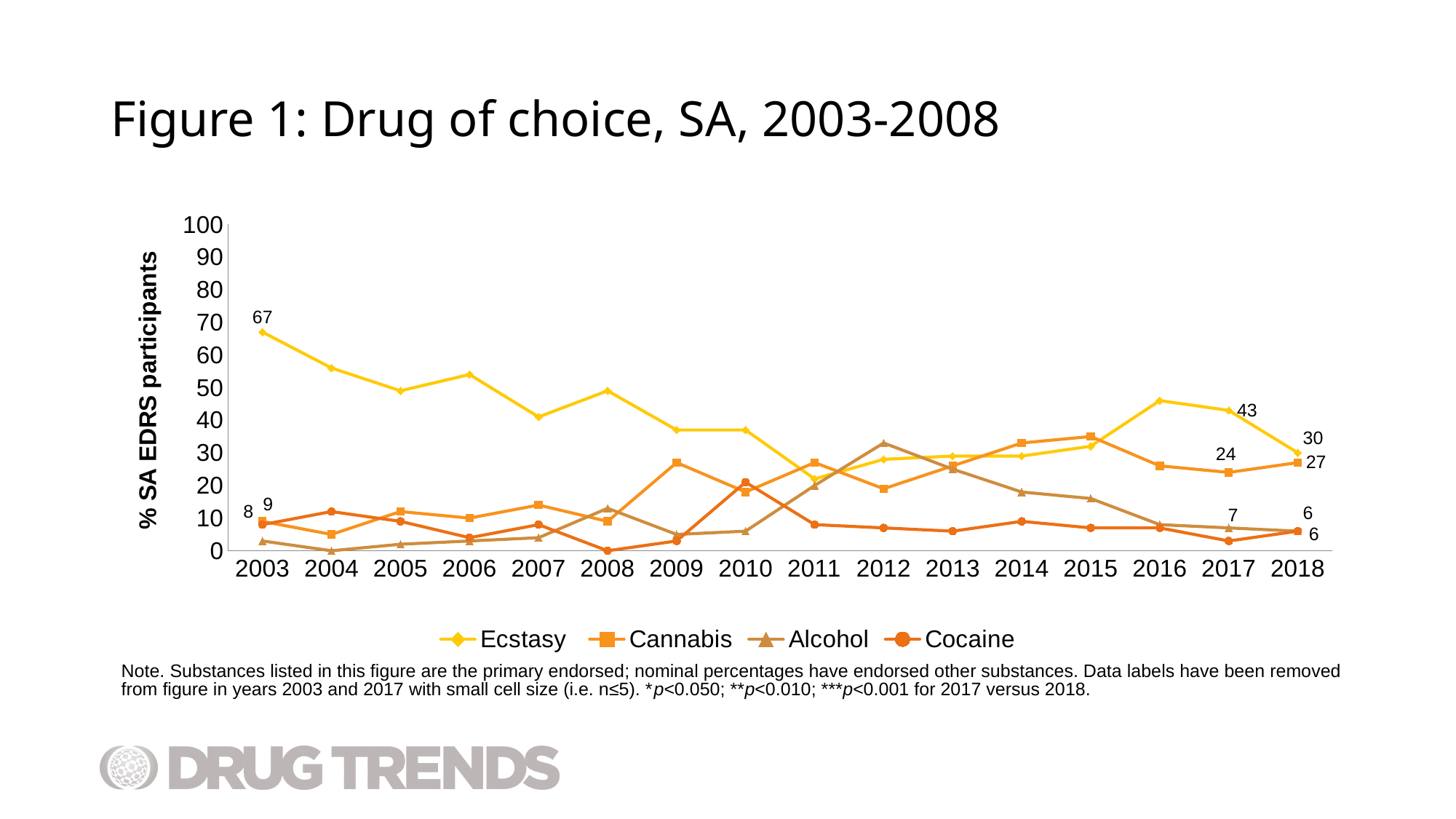
By how much did the Ecstasy value fall between 2003 and 2018? 37 How many years are shown along the x axis? 16 What is the value for Cannabis in 2018? 27 What is the value for Cannabis in 2017? 24 What kind of chart is shown on the slide? Line chart Which series has the highest value in 2003? Ecstasy How many series does the legend list? 4 What is the value for Ecstasy in 2017? 43 What is the value for Ecstasy in 2018? 30 What is the label on the y axis? % SA EDRS participants What is the value for Ecstasy in 2003? 67 Is the value for Ecstasy in 2004 greater or less than 50? greater